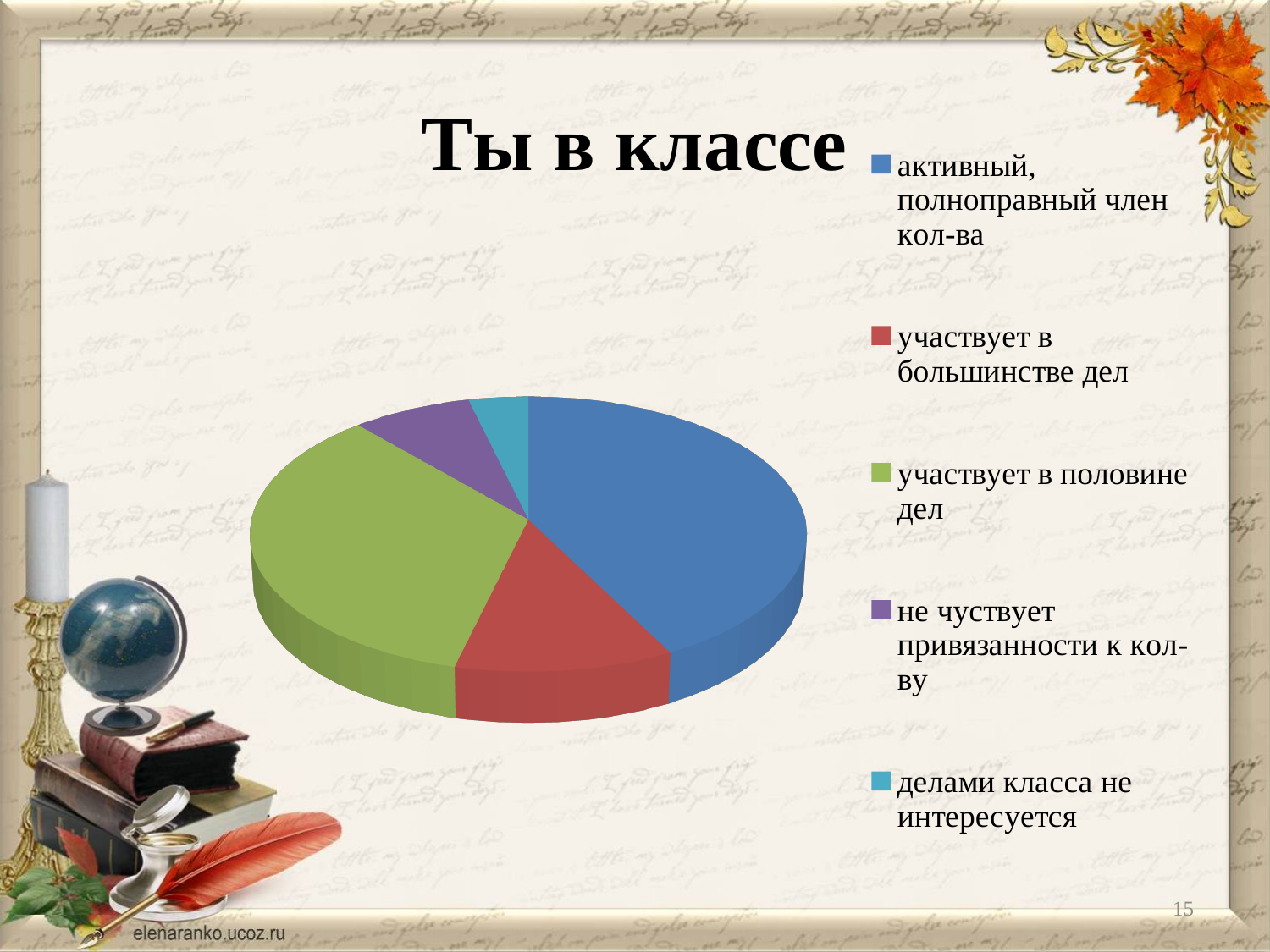
Which category has the smallest slice of the pie? делами класса не интересуется What kind of chart is shown on the slide? pie chart How many entries does the legend list? 5 What colour is the slice for "участвует в половине дел"? green How many slices does the pie chart have? 5 Which slice is larger: "активный, полноправный член кол-ва" or "участвует в большинстве дел"? активный, полноправный член кол-ва Which slice is larger: "не чуствует привязанности к кол-ву" or "делами класса не интересуется"? не чуствует привязанности к кол-ву What is the title of the chart? Ты в классе Which category has the largest slice of the pie? активный, полноправный член кол-ва Which slice is larger: "участвует в большинстве дел" or "участвует в половине дел"? участвует в половине дел